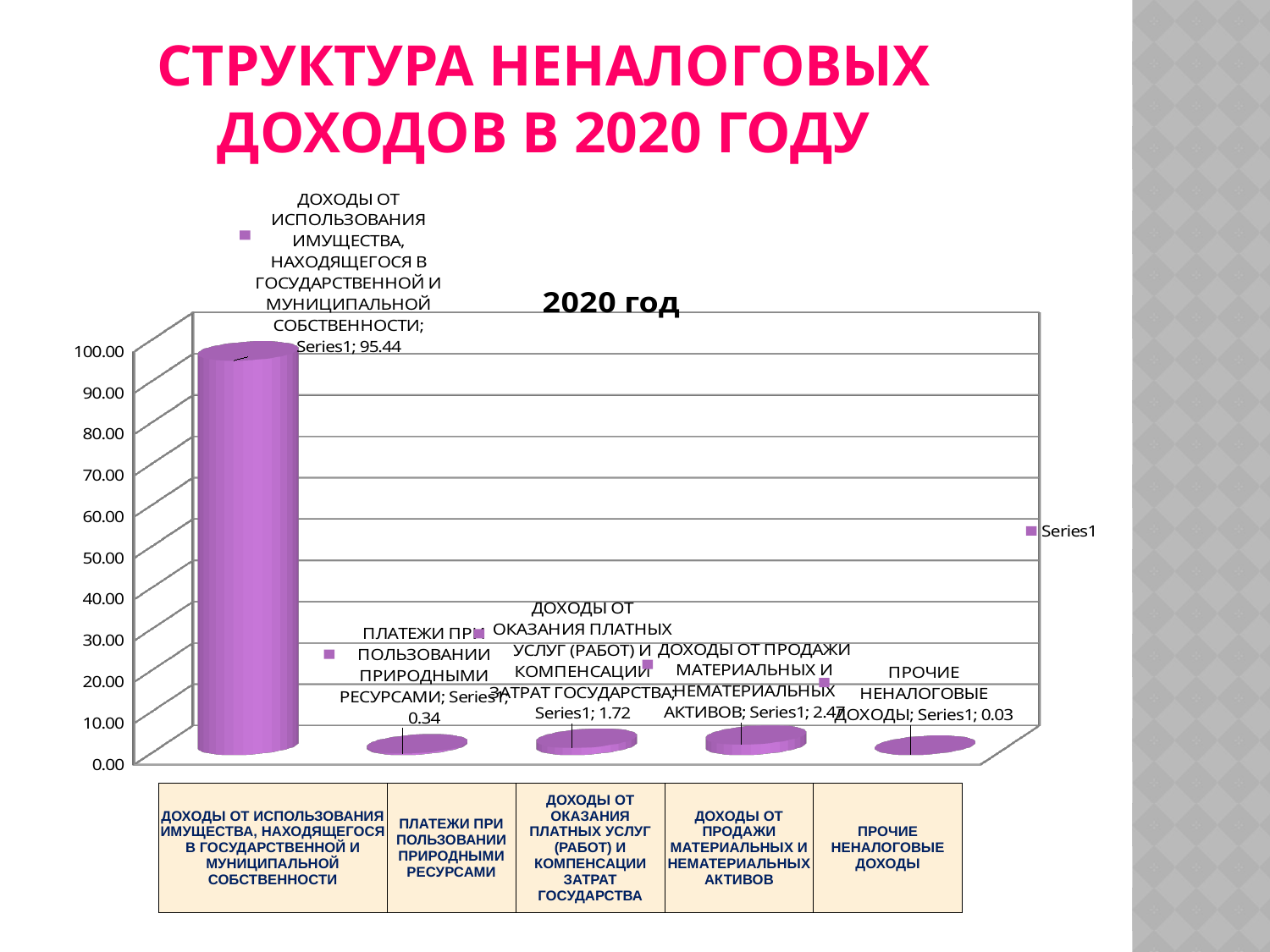
What is the value for ДОХОДЫ ОТ ПРОДАЖИ МАТЕРИАЛЬНЫХ И НЕМАТЕРИАЛЬНЫХ АКТИВОВ? 2.47 What kind of chart is shown on the slide? Bar chart What is the value for ПЛАТЕЖИ ПРИ ПОЛЬЗОВАНИИ ПРИРОДНЫМИ РЕСУРСАМИ? 0.34 What is the value for ПРОЧИЕ НЕНАЛОГОВЫЕ ДОХОДЫ? 0.03 What is the difference between the value for ДОХОДЫ ОТ ПРОДАЖИ МАТЕРИАЛЬНЫХ И НЕМАТЕРИАЛЬНЫХ АКТИВОВ and the value for ДОХОДЫ ОТ ОКАЗАНИЯ ПЛАТНЫХ УСЛУГ (РАБОТ) И КОМПЕНСАЦИИ ЗАТРАТ ГОСУДАРСТВА? 0.75 How many series does the legend list? 1 Which category has the lowest value? ПРОЧИЕ НЕНАЛОГОВЫЕ ДОХОДЫ What is the value for ДОХОДЫ ОТ ОКАЗАНИЯ ПЛАТНЫХ УСЛУГ (РАБОТ) И КОМПЕНСАЦИИ ЗАТРАТ ГОСУДАРСТВА? 1.72 Which category has the highest value? ДОХОДЫ ОТ ИСПОЛЬЗОВАНИЯ ИМУЩЕСТВА, НАХОДЯЩЕГОСЯ В ГОСУДАРСТВЕННОЙ И МУНИЦИПАЛЬНОЙ СОБСТВЕННОСТИ How many categories are shown in the chart? 5 What is the value for ДОХОДЫ ОТ ИСПОЛЬЗОВАНИЯ ИМУЩЕСТВА, НАХОДЯЩЕГОСЯ В ГОСУДАРСТВЕННОЙ И МУНИЦИПАЛЬНОЙ СОБСТВЕННОСТИ? 95.44 Which is larger: the value for ПЛАТЕЖИ ПРИ ПОЛЬЗОВАНИИ ПРИРОДНЫМИ РЕСУРСАМИ or the value for ДОХОДЫ ОТ ОКАЗАНИЯ ПЛАТНЫХ УСЛУГ (РАБОТ) И КОМПЕНСАЦИИ ЗАТРАТ ГОСУДАРСТВА? ДОХОДЫ ОТ ОКАЗАНИЯ ПЛАТНЫХ УСЛУГ (РАБОТ) И КОМПЕНСАЦИИ ЗАТРАТ ГОСУДАРСТВА